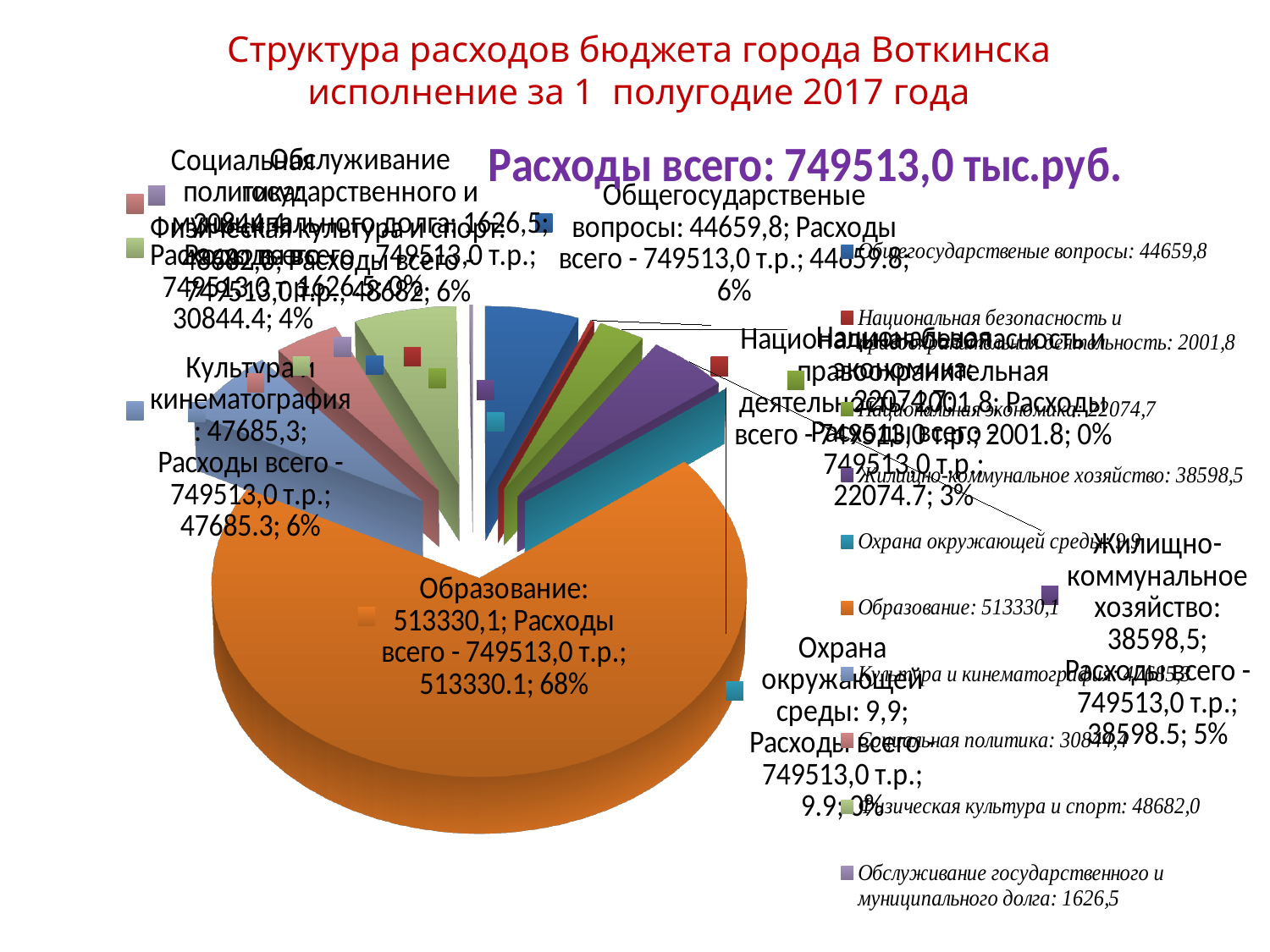
What total expenditure (Расходы всего) is stated on the slide? 749513,0 тыс.руб. What is the difference between the values for Образование and Общегосударственые вопросы? 468670,3 Which is larger: Физическая культура и спорт or Культура и кинематография? Физическая культура и спорт Which category has the largest slice of the pie chart? Образование What share of the pie does Образование account for? 68% What is the value for Жилищно-коммунальное хозяйство? 38598,5 What share of the pie does Социальная политика account for? 4% What kind of chart is shown on the slide? pie chart Which category has the smallest value in the pie chart? Охрана окружающей среды What is the value for Национальная экономика? 22074,7 How many categories does the legend of the pie chart list? 10 What is the value for Образование in the pie chart? 513330,1